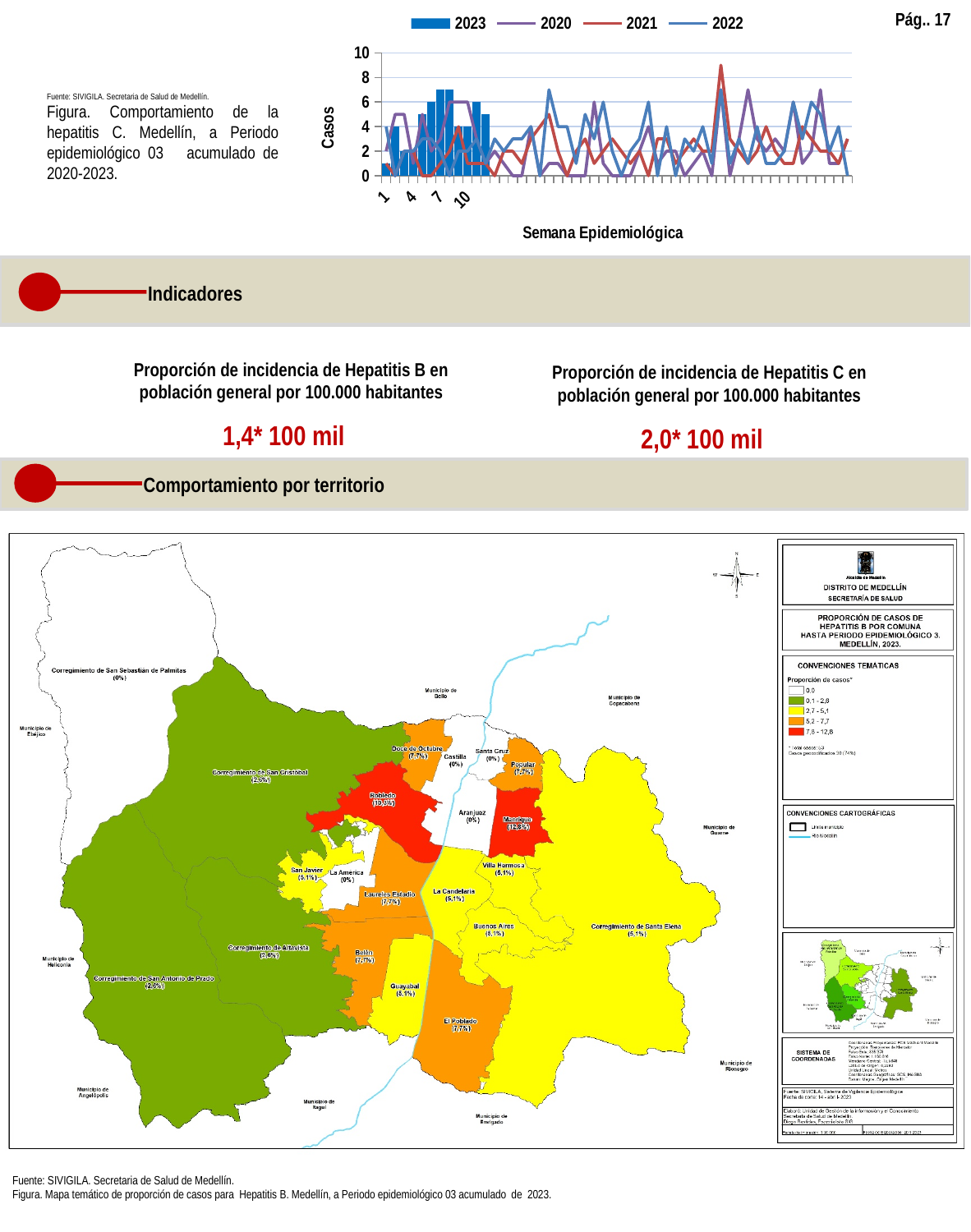
In the top chart, how many series does the legend list? 4 In the top chart, is the peak value of the 2021 line greater or less than 8? greater On the map, which is larger: the proportion for Villa Hermosa or for Belén? Belén What is the label of the vertical axis of the top chart? Casos On the map, which comuna has the highest proportion of Hepatitis B cases? Manrique (12,8%) In the top chart, which is larger: the peak of the 2021 line or the tallest 2023 bar? the peak of the 2021 line In the top chart, is the tallest 2023 bar greater or less than 6? greater On the map, what proportion of cases is shown for Robledo? 10,3% In the top chart, which year is plotted as bars rather than a line? 2023 On the map, what is the difference between the proportions for Manrique and Robledo? 2,5% In the top chart, which series reaches the highest value of all? 2021 On the map, what proportion of cases is shown for El Poblado? 7,7%